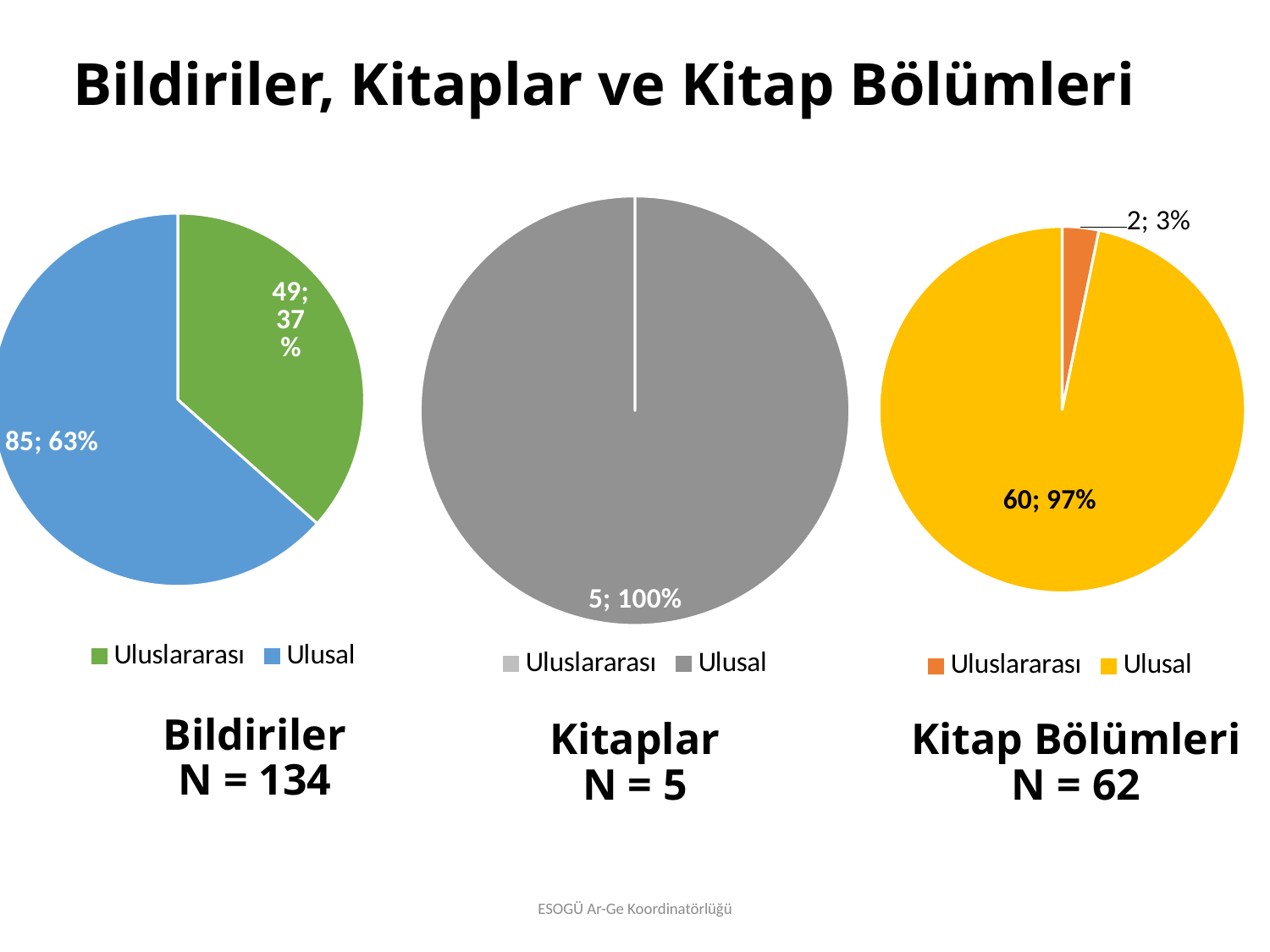
In the Kitaplar pie chart, what share of the pie does Ulusal take? 100% In the Kitap Bölümleri pie chart, which category is the smallest? Uluslararası In the Bildiriler pie chart, what is the difference between the Ulusal count and the Uluslararası count? 36 In the Bildiriler pie chart, what is the value for Ulusal? 85; 63% In the Kitap Bölümleri pie chart, what is the value for Ulusal? 60; 97% In the Kitap Bölümleri pie chart, what is the value for Uluslararası? 2; 3% In the Bildiriler pie chart, what share of the pie does Uluslararası take? 37% How many entries does the legend of the Kitap Bölümleri chart list? 2 How many pie charts are shown on the slide? 3 In the Bildiriler pie chart, what is the value for Uluslararası? 49; 37% In the Bildiriler pie chart, which category is larger, Ulusal or Uluslararası? Ulusal In the Kitaplar pie chart, what is the value shown for Ulusal? 5; 100%